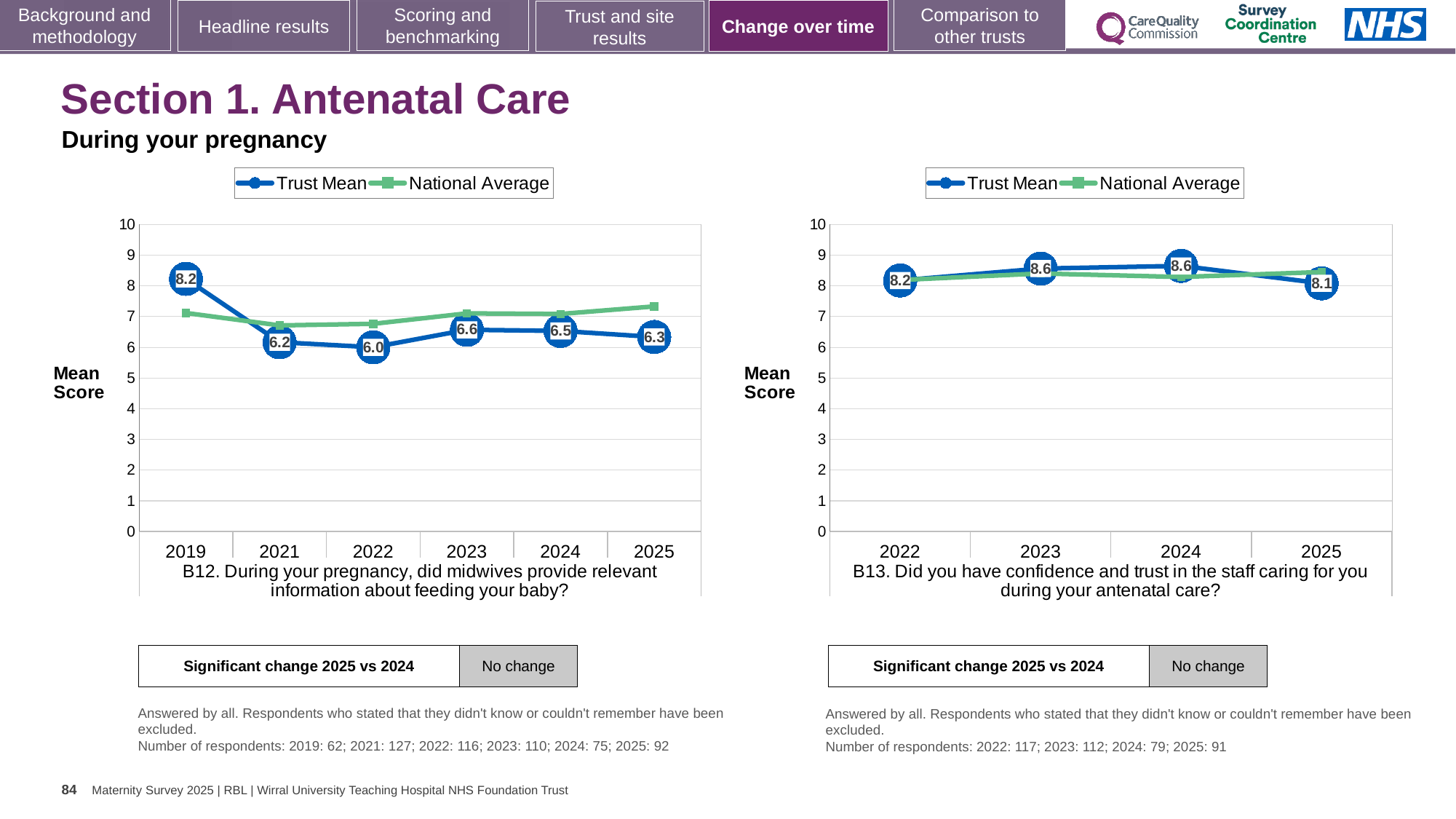
In the B12 chart (left), is the National Average for 2025 greater or less than 7? greater How many series does the legend of the B13 chart (right) list? 2 What type of chart is the B12 chart (left)? Line chart In the B12 chart (left), which year has the highest Trust Mean score? 2019 In the B12 chart (left), what is the Trust Mean score for 2022? 6.0 In the B13 chart (right), which is larger, the Trust Mean for 2023 or for 2025? 2023 In the B12 chart (left), how many years are shown on the x axis? 6 In the B13 chart (right), what is the difference between the Trust Mean scores for 2024 and 2025? 0.5 In the B13 chart (right), what is the Trust Mean score for 2025? 8.1 In the B12 chart (left), what is the Trust Mean score for 2019? 8.2 In the B12 chart (left), which year has the lowest Trust Mean score? 2022 In the B12 chart (left), what is the difference between the Trust Mean scores for 2019 and 2021? 2.0